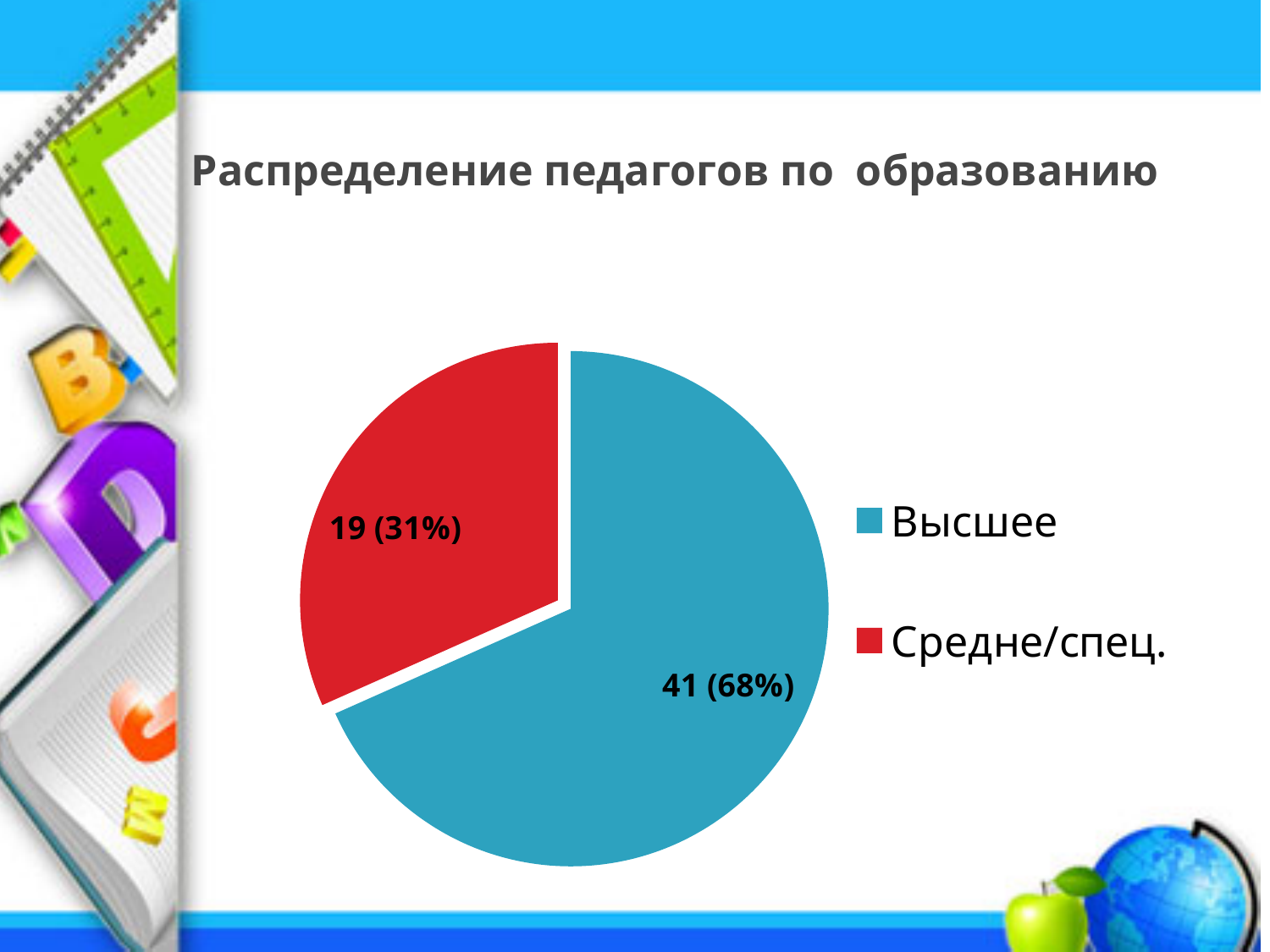
Which category has the largest slice of the pie? Высшее How many slices does the pie chart have? 2 What is the title of the chart? Распределение педагогов по образованию Which category has the smallest slice of the pie? Средне/спец. What is the value shown for Высшее? 41 (68%) What is the value shown for Средне/спец.? 19 (31%) Which is larger, the slice for Высшее or the slice for Средне/спец.? Высшее How many entries does the legend list? 2 What is the difference in count between Высшее and Средне/спец.? 22 What colour is the slice for Средне/спец.? red What share of the pie does Средне/спец. represent? 31% What kind of chart is shown on the slide? pie chart